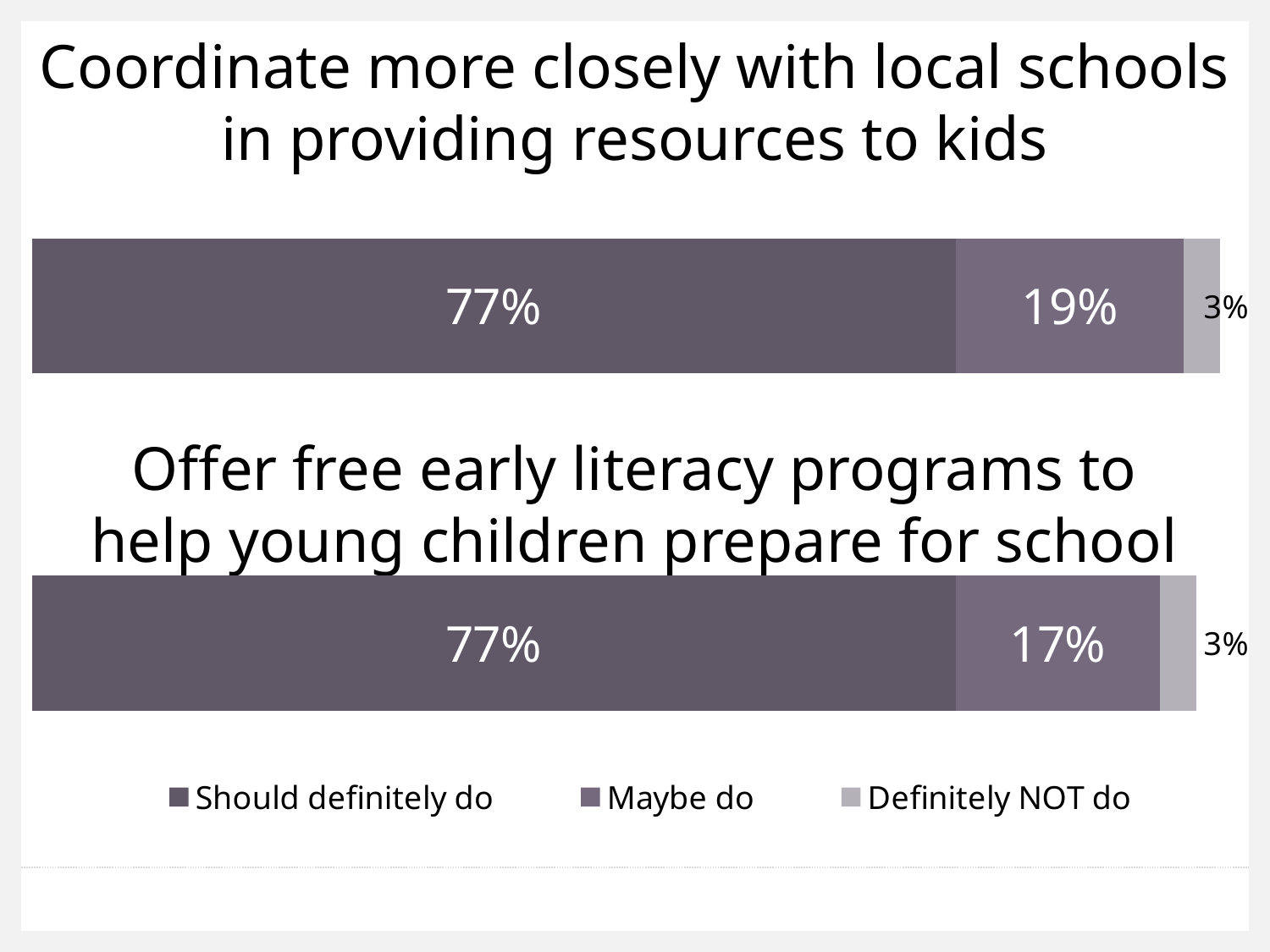
What kind of chart is shown on the slide? Stacked bar chart What percentage said "Should definitely do" for "Coordinate more closely with local schools in providing resources to kids"? 77% What is the difference between the "Maybe do" percentages for the two items? 2% What percentage said "Should definitely do" for "Offer free early literacy programs to help young children prepare for school"? 77% Which response category has the smallest share for "Offer free early literacy programs to help young children prepare for school"? Definitely NOT do Which item has the larger "Maybe do" percentage? Coordinate more closely with local schools in providing resources to kids How many series does the legend list? 3 What percentage said "Maybe do" for "Coordinate more closely with local schools in providing resources to kids"? 19% What percentage said "Definitely NOT do" for "Offer free early literacy programs to help young children prepare for school"? 3% How many items (bars) are shown on the chart? 2 Which response category has the largest share for "Coordinate more closely with local schools in providing resources to kids"? Should definitely do What percentage said "Maybe do" for "Offer free early literacy programs to help young children prepare for school"? 17%